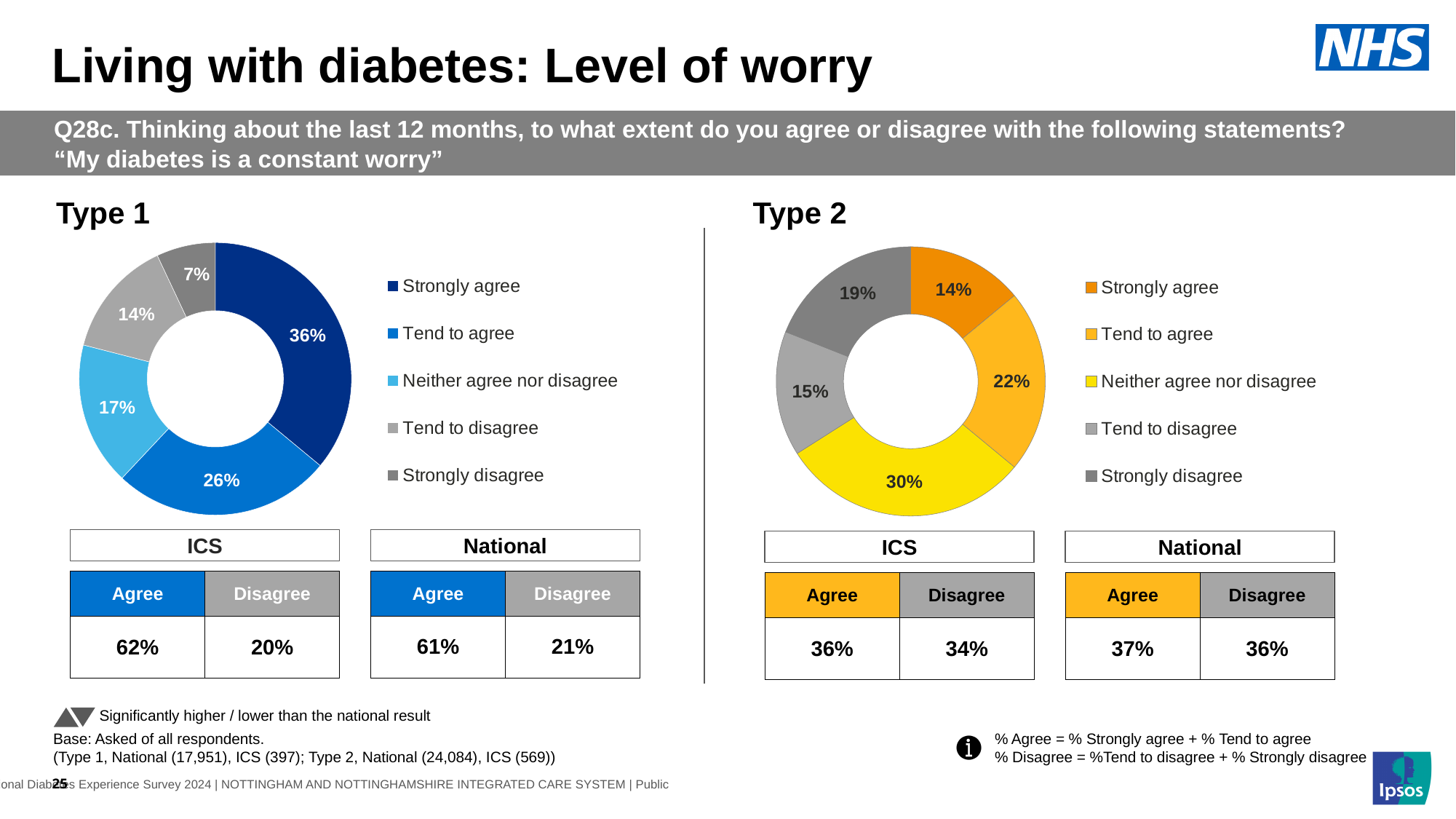
In the Type 2 chart, what percentage of respondents tend to disagree? 15% In the Type 1 chart, what colour is the Strongly agree segment? Dark blue In the Type 1 chart, what percentage of respondents strongly disagree? 7% How many categories does the Type 1 chart show? 5 What kind of chart is used for Type 2? Doughnut (pie) chart In the Type 1 chart, what is the difference between the Tend to agree and Tend to disagree shares? 12 percentage points How many entries does the legend of the Type 2 chart list? 5 In the Type 2 chart, what percentage of respondents neither agree nor disagree? 30% In the Type 2 chart, which category has the smallest share? Strongly agree In the Type 1 chart, what percentage of respondents strongly agree? 36% In the Type 2 chart, which is larger: Tend to agree or Strongly disagree? Tend to agree In the Type 1 chart, which category has the largest share? Strongly agree